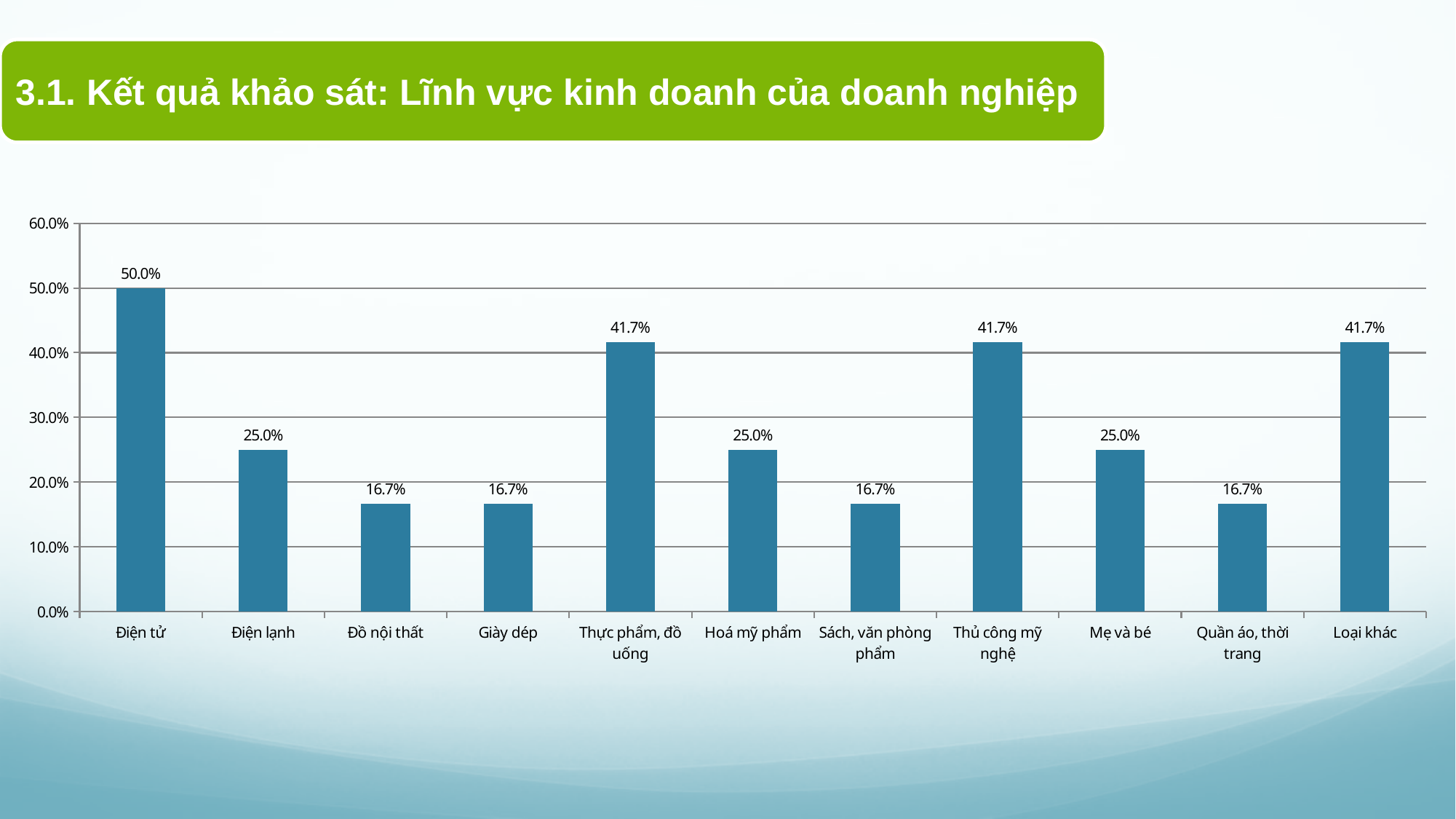
How many categories are shown on the x axis? 11 What is the value for Loại khác? 41.7% Which is larger, the value for Thực phẩm, đồ uống or the value for Giày dép? Thực phẩm, đồ uống What is the difference between the values for Điện tử and Điện lạnh? 25.0% What is the value for Điện tử? 50.0% Is the value for Quần áo, thời trang greater or less than 20.0%? less What is the value for Hoá mỹ phẩm? 25.0% What is the highest value shown on the y axis? 60.0% What kind of chart is shown on the slide? bar chart What is the value for Sách, văn phòng phẩm? 16.7% What is the difference between the values for Thủ công mỹ nghệ and Mẹ và bé? 16.7% Which category has the highest value? Điện tử